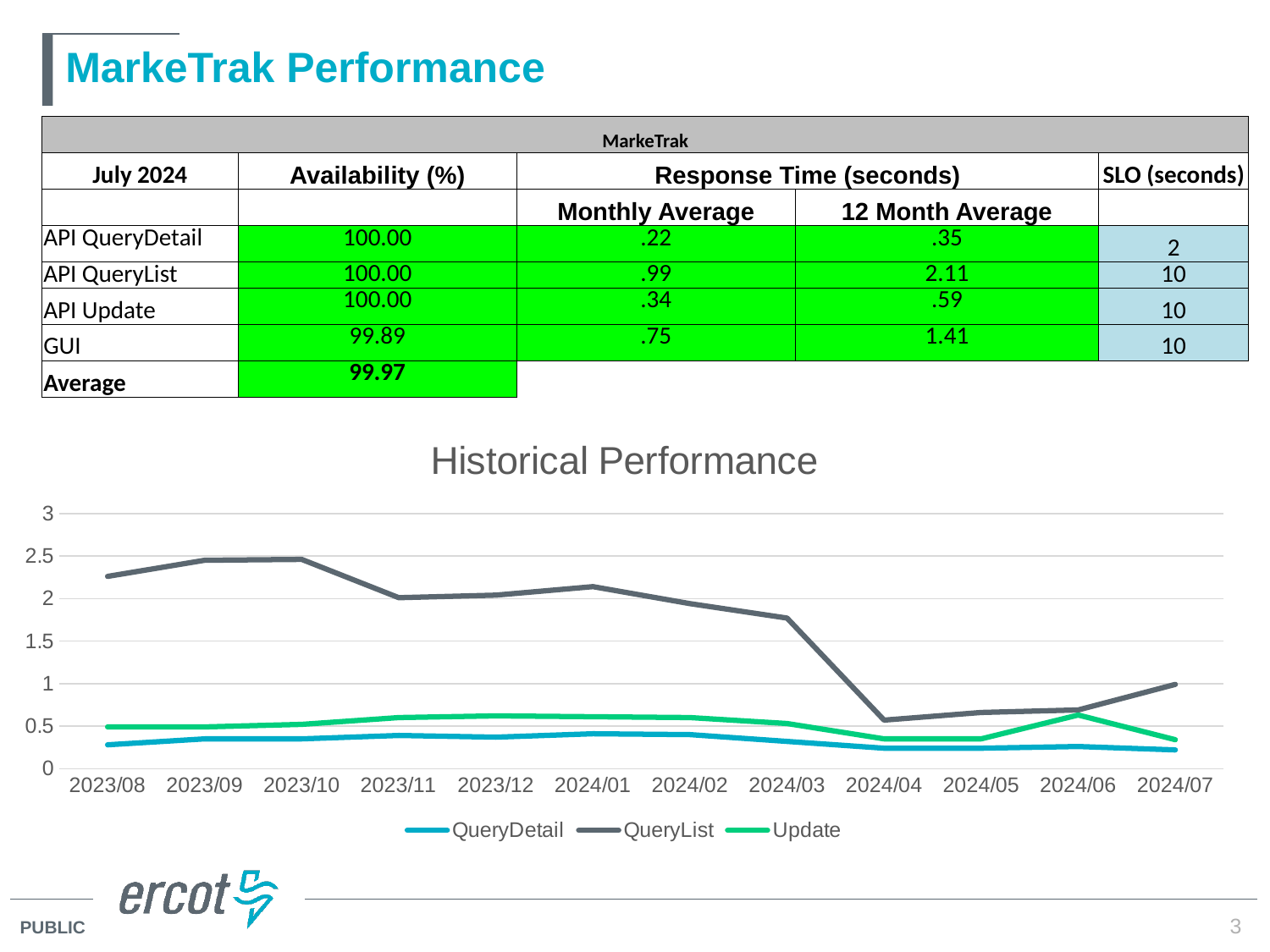
In the Historical Performance chart, does the QueryList series rise or fall from 2023/10 to 2024/04? fall How many series does the legend of the Historical Performance chart list? 3 In the Historical Performance chart, is the QueryList value for 2024/04 greater or less than 1? less How many months are plotted along the x axis of the Historical Performance chart? 12 What kind of chart is the Historical Performance chart? line chart In the Historical Performance chart, is the QueryDetail value for 2024/07 greater or less than 0.5? less In the Historical Performance chart, is the Update value for 2024/06 greater or less than 0.5? greater What is the title of the chart on the slide? Historical Performance In the Historical Performance chart, which is larger at 2024/07: Update or QueryDetail? Update Which series in the Historical Performance chart has the highest values across the period? QueryList Which series in the Historical Performance chart has the lowest values across the period? QueryDetail